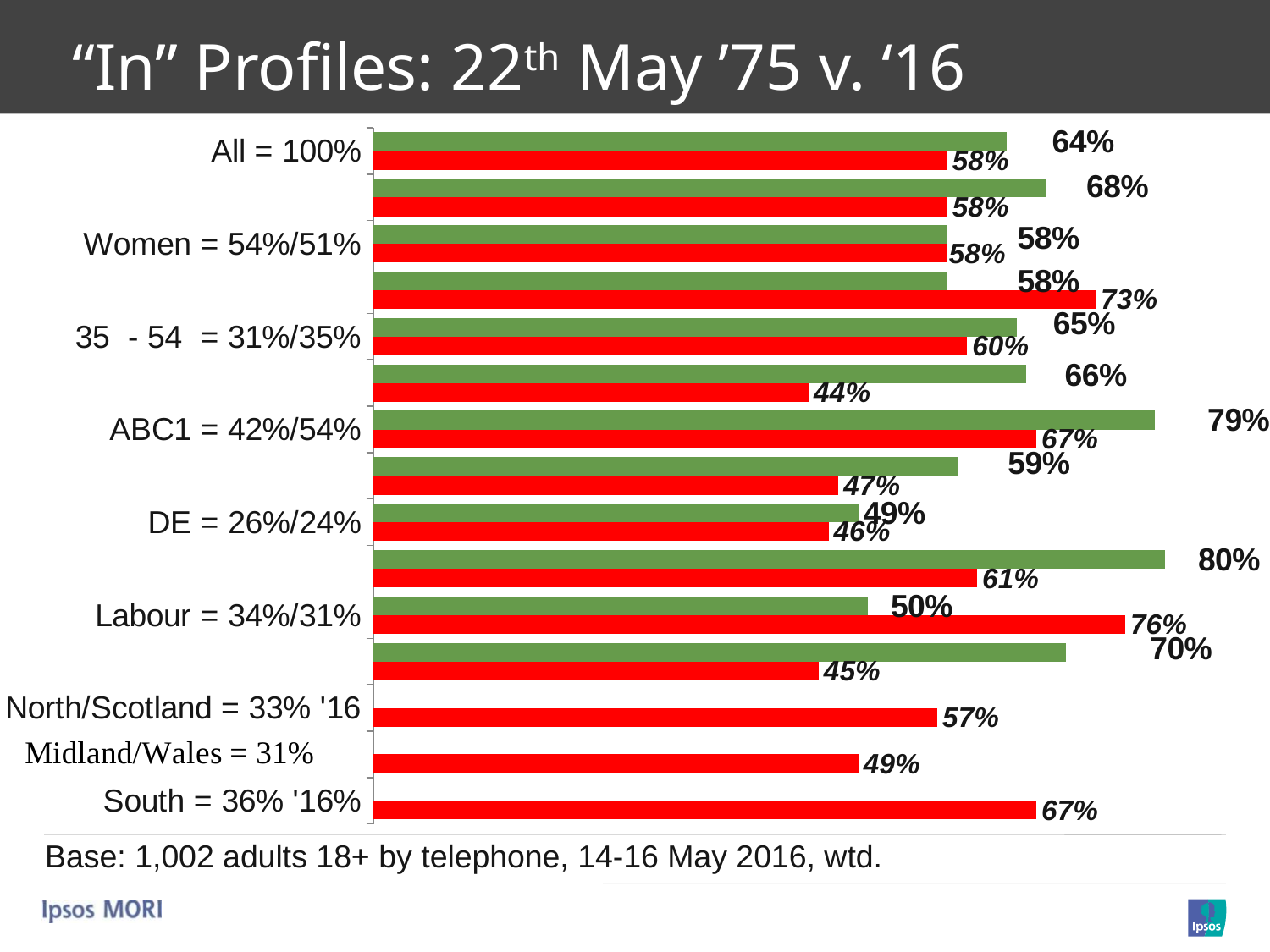
What type of chart is shown on the slide? Bar chart What is the value of the green bar for "All = 100%"? 64% What is the value of the red bar for "Labour = 34%/31%"? 76% For DE, which bar is larger, the green bar or the red bar? The green bar (49%) What is the value of the red bar for "All = 100%"? 58% What is the highest value labelled on the chart? 80% What is the value of the red bar for "South = 36% '16%"? 67% What is the difference between the green bar (79%) and the red bar (67%) for ABC1? 12 percentage points What is the value of the green bar for "ABC1 = 42%/54%"? 79% For Labour, which bar is larger, the green bar or the red bar? The red bar (76%) What is the value of the red bar for "North/Scotland = 33% '16"? 57% What is the value of the red bar for "Midland/Wales = 31%"? 49%